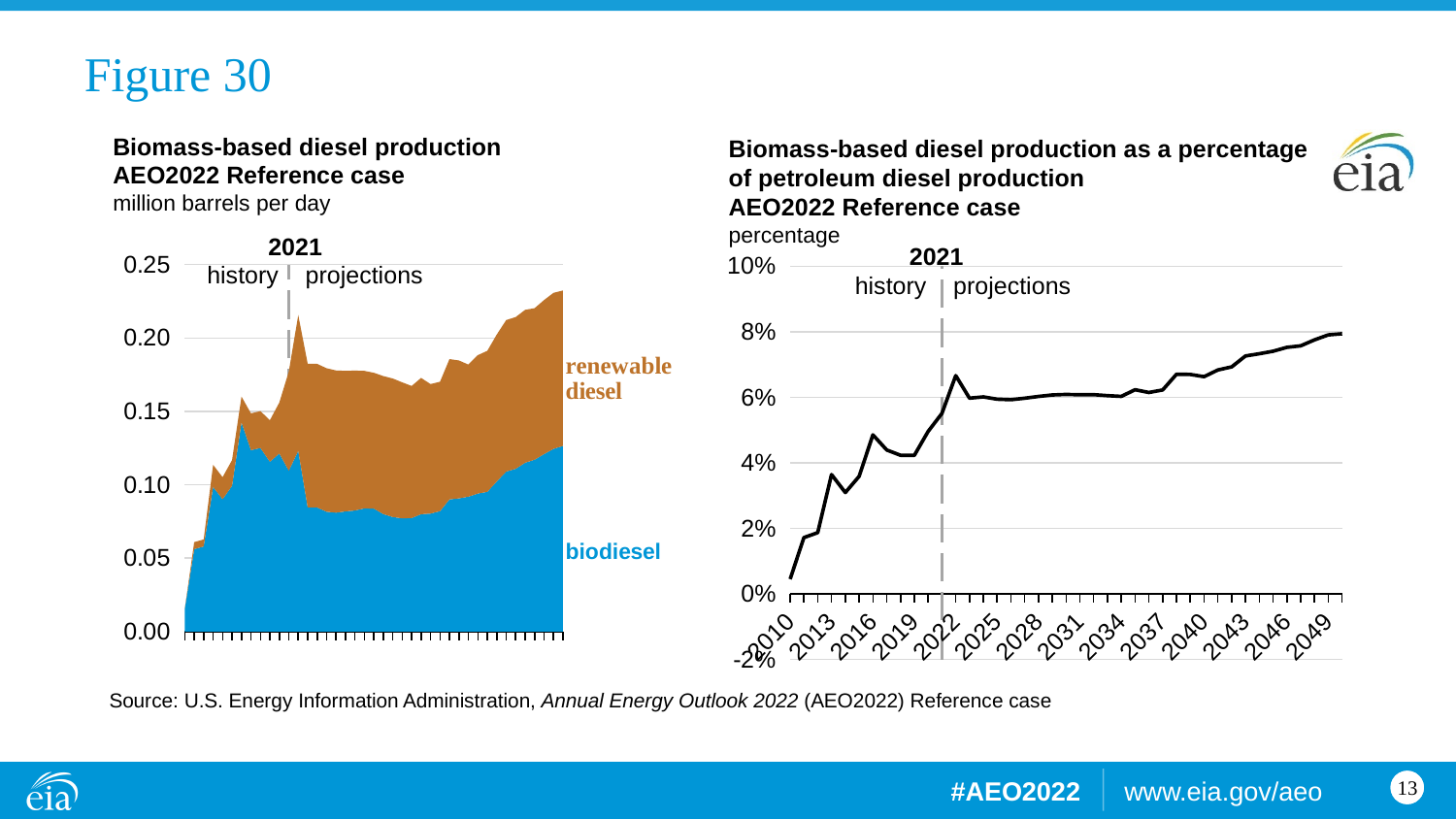
What kind of chart is the right chart, 'Biomass-based diesel production as a percentage of petroleum diesel production'? line chart In the left chart, which series is shown in blue? biodiesel In the right chart, is the value for 2040 greater or less than 6%? greater In the right chart, is the value for 2016 greater or less than 4%? greater In the right chart, does the percentage generally rise or fall from 2010 to 2049? rise In the right chart, is the value for 2010 greater or less than 2%? less In the left chart, how many series are stacked? 2 What kind of chart is the left chart, 'Biomass-based diesel production'? stacked area chart In the left chart, what unit is production measured in? million barrels per day